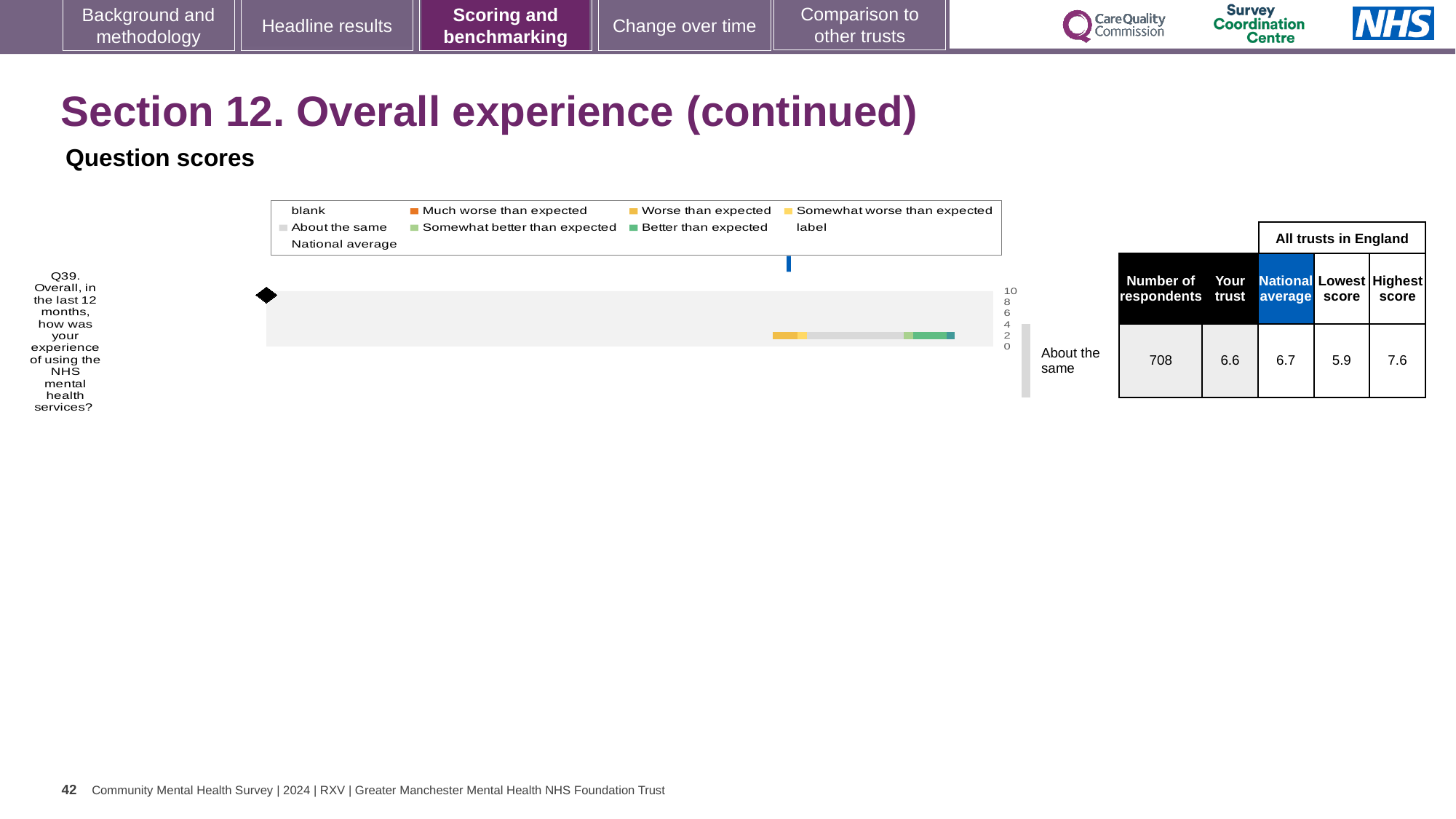
Which is larger for Q39, the trust's score or the national average? National average What is the national average score for Q39? 6.7 What is the difference between the highest and lowest scores for Q39 across all trusts in England? 1.7 How many respondents answered Q39? 708 Which benchmarking category is the trust's Q39 score placed in? About the same Is the trust's Q39 score greater or less than 6 on the chart's axis? greater How many questions are plotted on the chart? 1 What kind of chart is used to show the Q39 score? bar chart How many entries does the chart legend list? 9 What is the highest score among all trusts in England for Q39? 7.6 What is the lowest score among all trusts in England for Q39? 5.9 What is the 'Your trust' score for Q39? 6.6